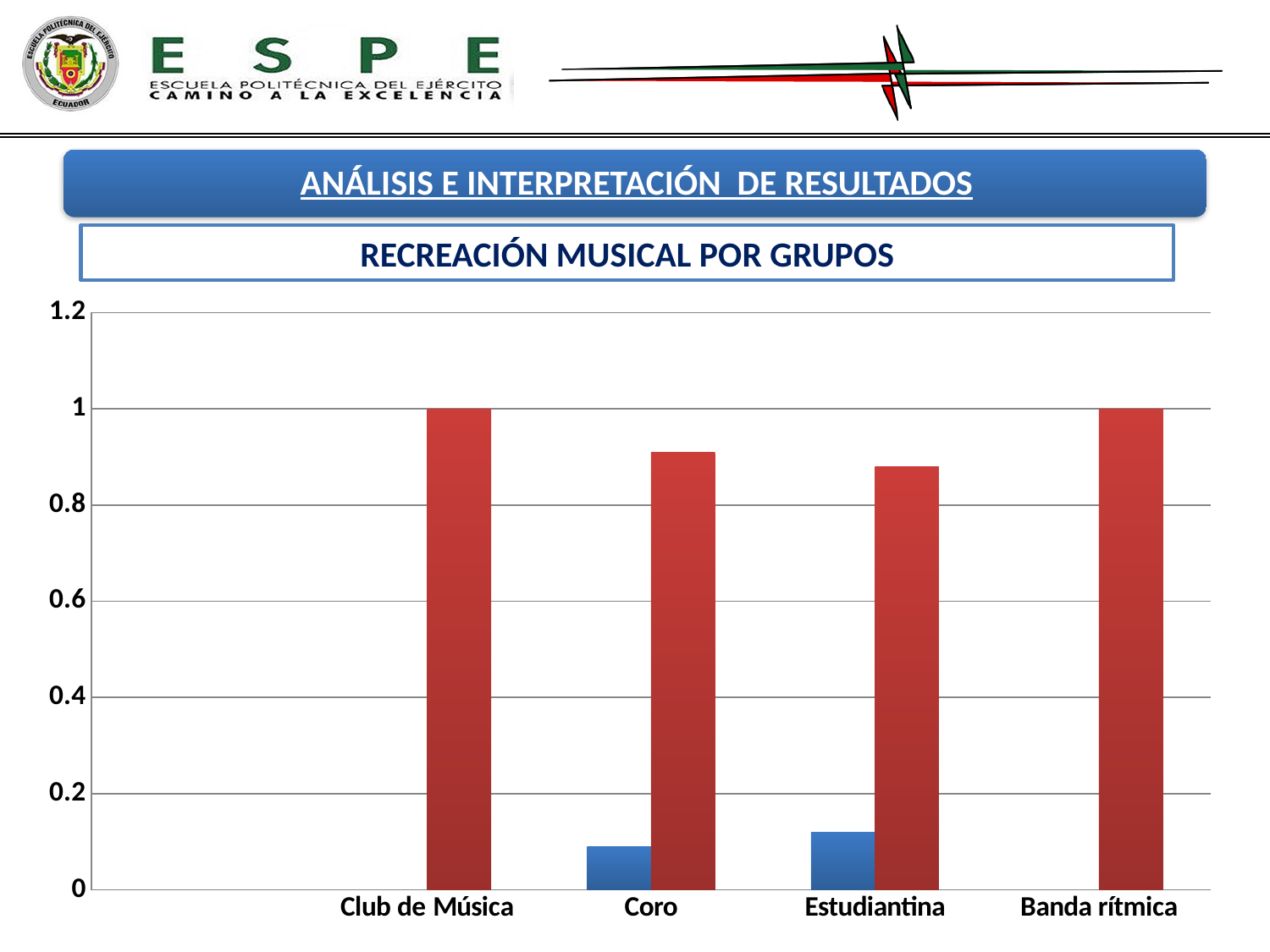
Is the value of the red bar for Coro greater or less than 0.8? greater How many groups (categories) are shown on the x axis of the chart? 4 Which red bar is taller, Coro or Estudiantina? Coro What is the title shown above the chart? RECREACIÓN MUSICAL POR GRUPOS What is the value of the red bar for Banda rítmica? 1 Is the value of the blue bar for Estudiantina greater or less than 0.2? less Is the value of the blue bar for Coro greater or less than 0.2? less What is the value of the red bar for Club de Música? 1 Which group has the lowest red bar? Estudiantina What type of chart is shown on the slide? Bar chart Which blue bar is taller, Coro or Estudiantina? Estudiantina